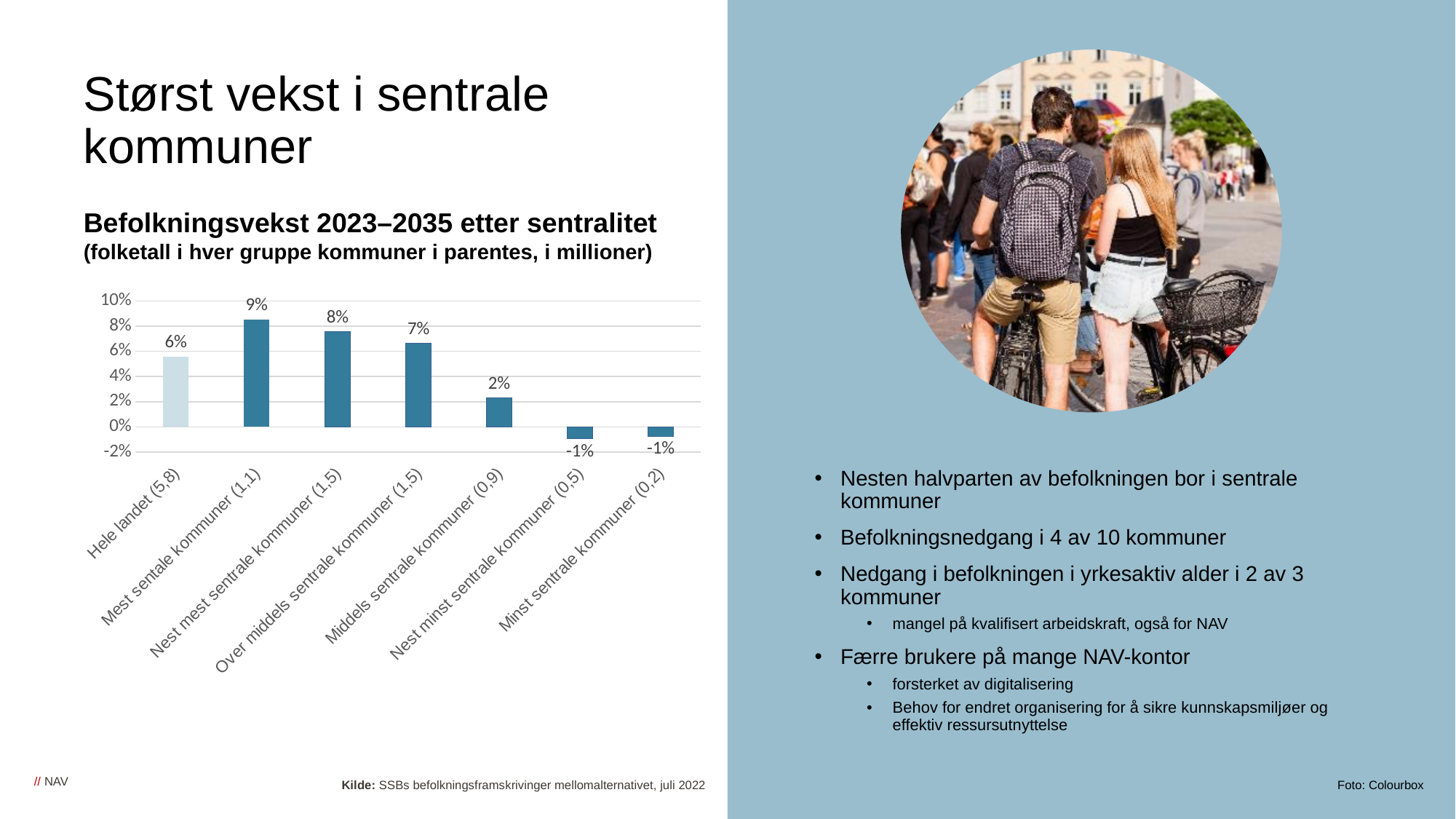
Do the values generally rise or fall moving from left to right after the first bar? Fall Which is larger: the value for 'Nest mest sentrale kommuner (1,5)' or 'Over middels sentrale kommuner (1,5)'? Nest mest sentrale kommuner (1,5) What is the population growth value shown for 'Mest sentrale kommuner (1,1)'? 9% What is the title of the chart? Befolkningsvekst 2023–2035 etter sentralitet Is the value for 'Nest minst sentrale kommuner (0,5)' greater or less than 0%? less How many categories are shown on the x axis of the chart? 7 What is the value shown for 'Middels sentrale kommuner (0,9)'? 2% Which category has the highest population growth in the chart? Mest sentrale kommuner (1,1) What is the value shown for 'Hele landet (5,8)'? 6% What kind of chart is shown on the slide? Bar chart What is the difference between the values for 'Mest sentrale kommuner (1,1)' and 'Hele landet (5,8)'? 3% What is the value shown for 'Minst sentrale kommuner (0,2)'? -1%